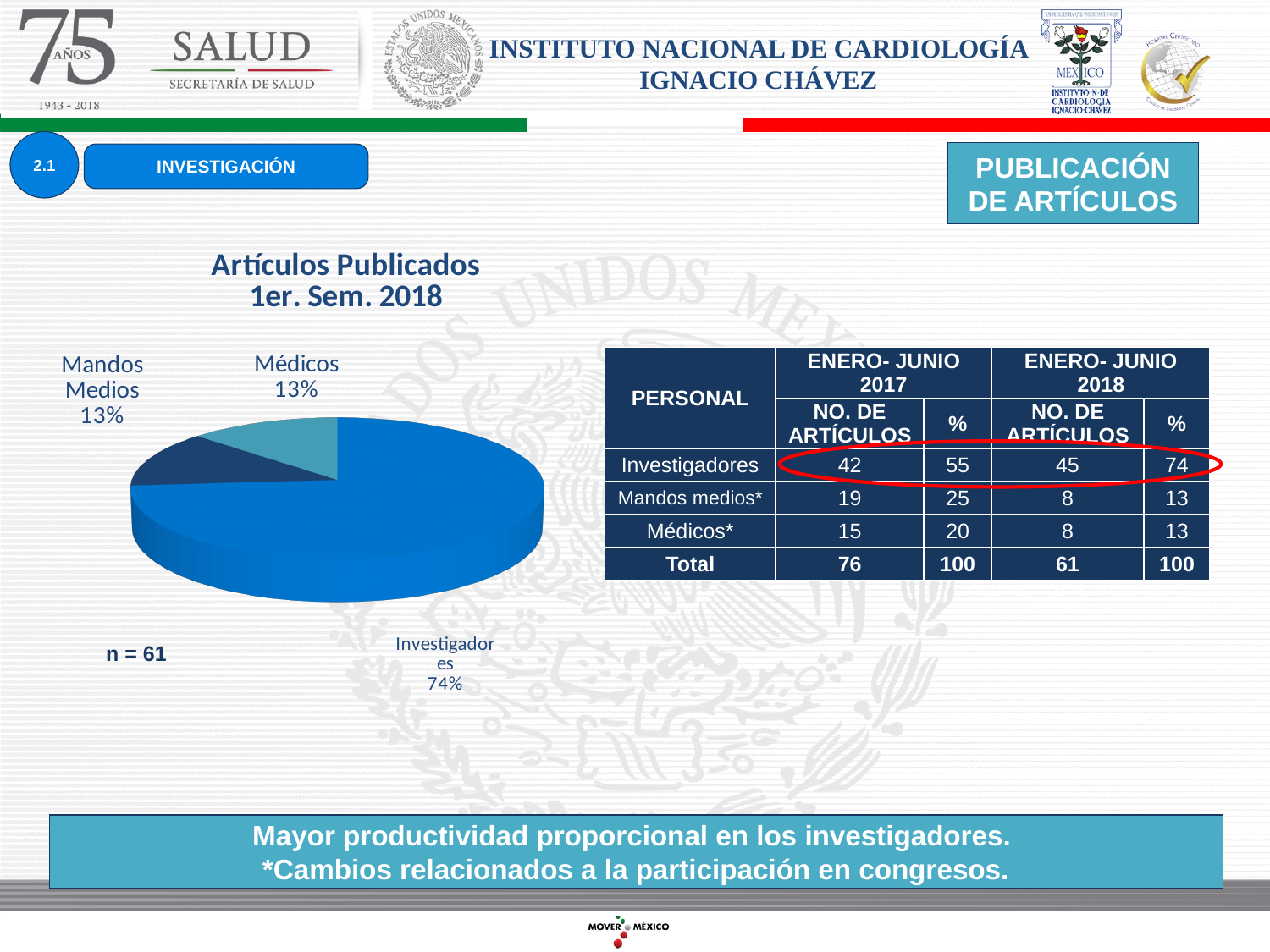
Is the share for Investigadores greater or less than 50%? greater How many slices does the pie chart have? 3 What is the value of n shown below the pie chart? n = 61 Which is larger, the Investigadores slice or the Mandos Medios slice? Investigadores What share of the pie does Mandos Medios represent? 13% Which category has the largest slice of the pie? Investigadores What is the difference in percentage points between the Investigadores slice and the Médicos slice? 61 What is the combined share of the Mandos Medios and Médicos slices? 26% What share of the pie does Investigadores represent? 74% What share of the pie does Médicos represent? 13% What is the title of the chart? Artículos Publicados 1er. Sem. 2018 What type of chart is shown on the slide? pie chart